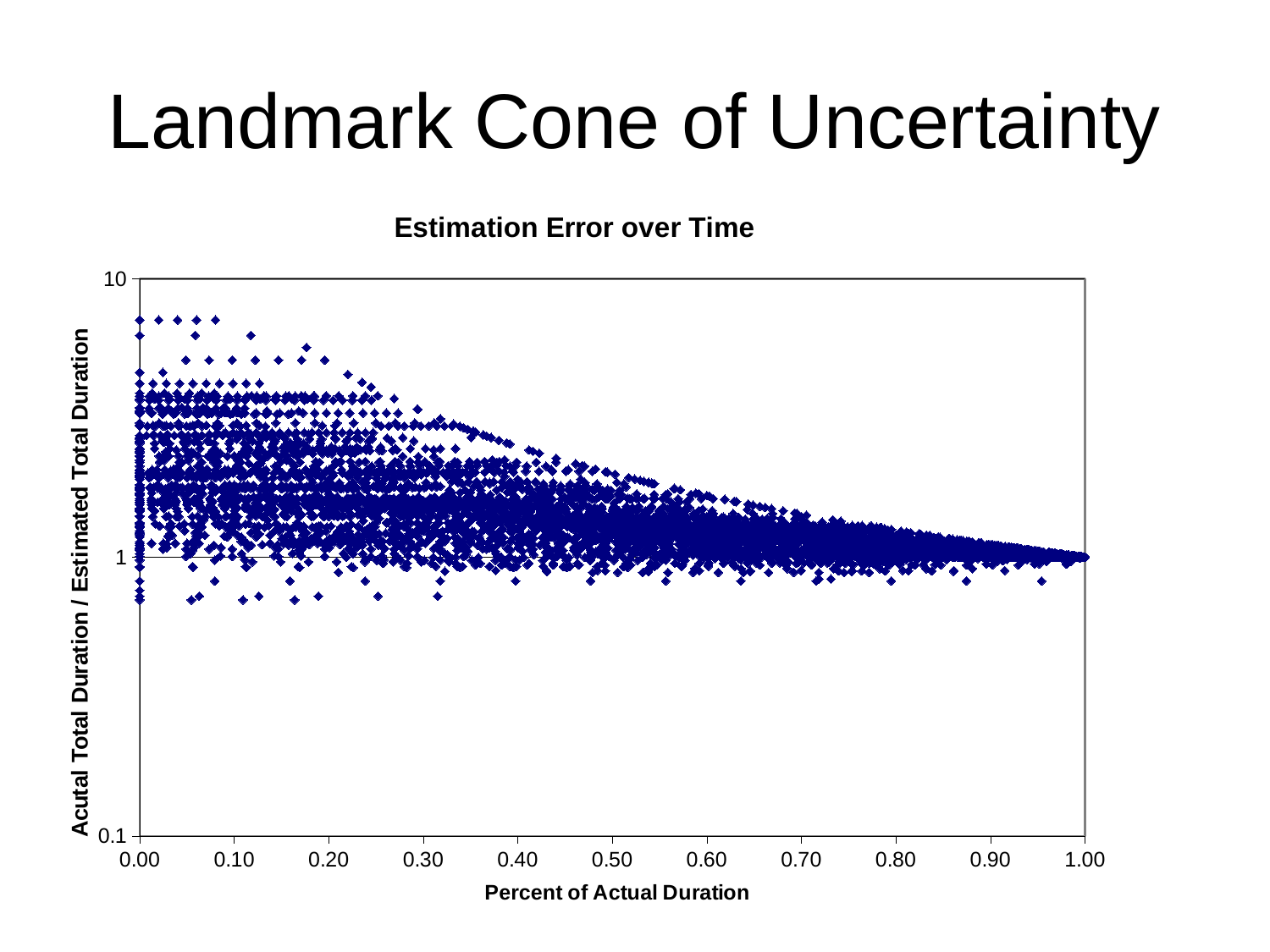
What is the label of the x axis of the chart? Percent of Actual Duration What is the lowest tick value shown on the y axis? 0.1 As Percent of Actual Duration increases toward 1.00, does the spread of the plotted points widen or narrow? narrow What is the title of the chart? Estimation Error over Time What is the highest tick value shown on the y axis? 10 Are all the plotted points greater or less than 10 on the y axis? less What kind of chart is shown on the slide? scatter chart What is the highest tick value shown on the x axis? 1.00 Are the highest plotted points near 0.00 on the x axis greater or less than 1 on the y axis? greater Toward which y-axis value do the points converge as Percent of Actual Duration approaches 1.00? 1